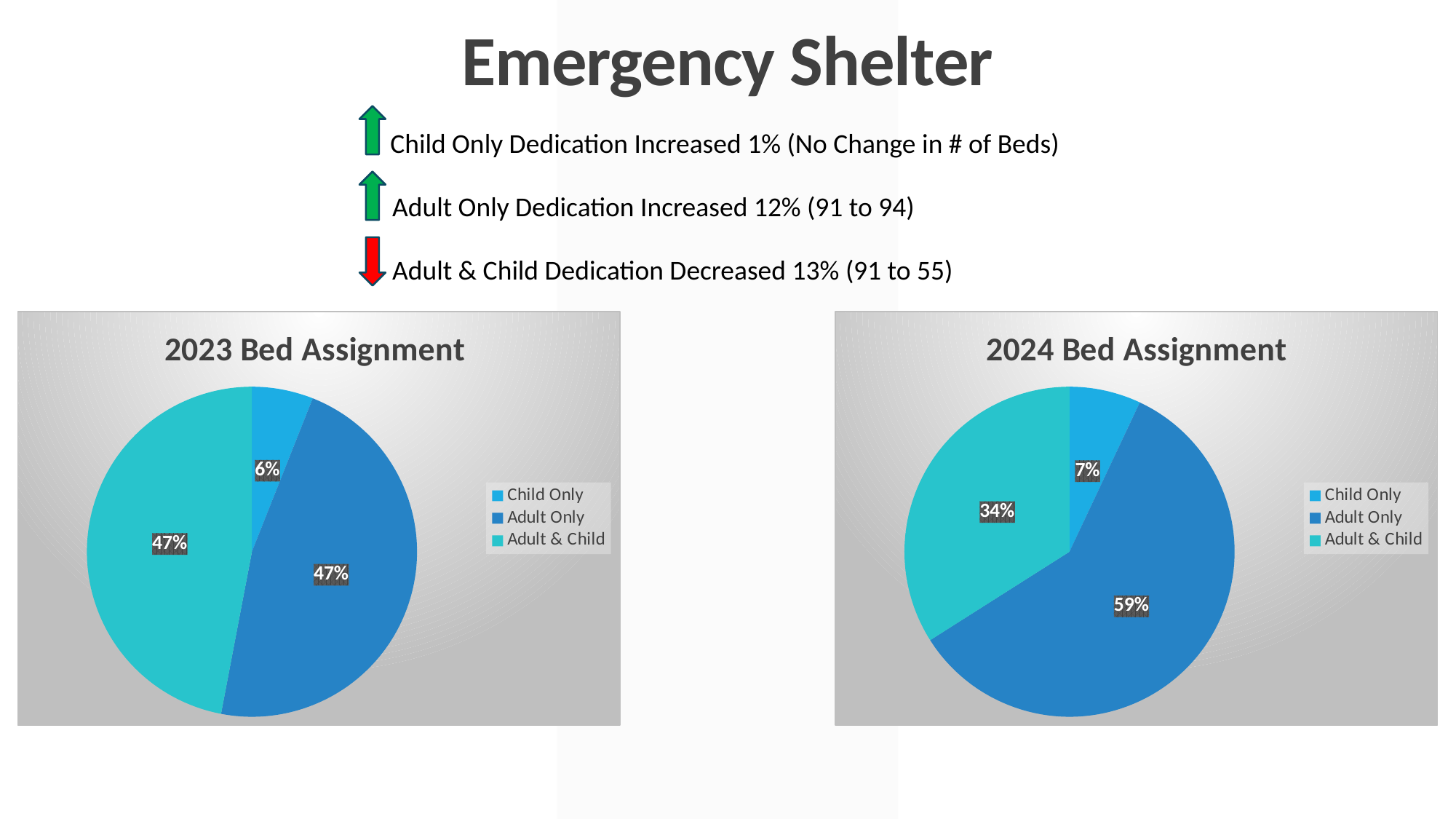
How many entries does the legend of the 2023 Bed Assignment chart list? 3 In the 2024 Bed Assignment chart, which is larger, Adult Only or Adult & Child? Adult Only In the 2023 Bed Assignment chart, what share of beds is Adult & Child? 47% In the 2024 Bed Assignment chart, what share of beds is Adult & Child? 34% What is the title of the chart on the right side of the slide? 2024 Bed Assignment In the 2023 Bed Assignment chart, what share of beds is Child Only? 6% In the 2024 Bed Assignment chart, which category has the largest share? Adult Only What kind of chart is the 2024 Bed Assignment chart? Pie chart In the 2024 Bed Assignment chart, what is the difference between the Adult Only and Adult & Child shares? 25% In the 2023 Bed Assignment chart, which category has the smallest share? Child Only In the 2024 Bed Assignment chart, what share of beds is Adult Only? 59% How many categories does the 2023 Bed Assignment chart show? 3